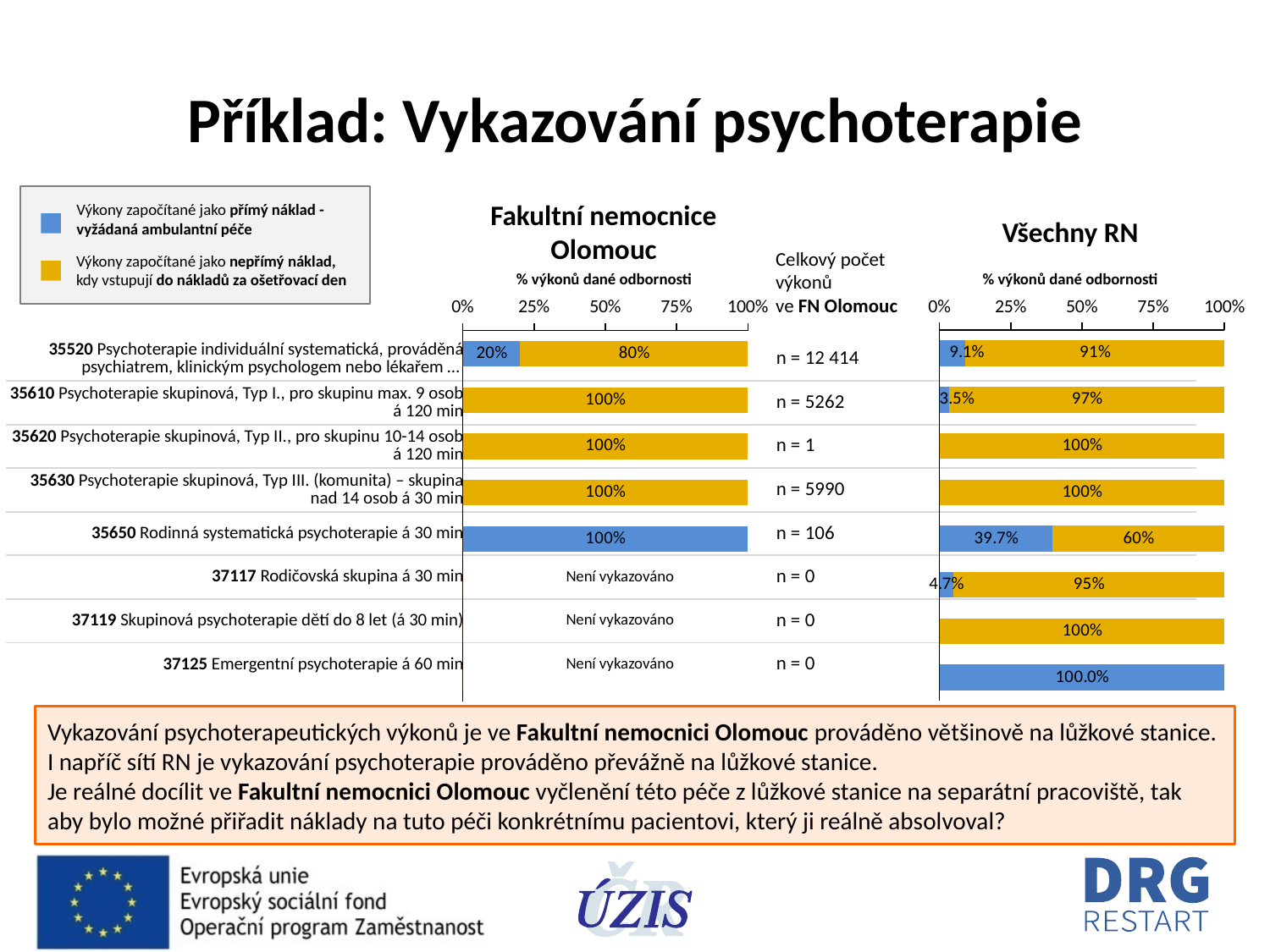
In the Všechny RN chart, what percentage is shown for procedure 37125 Emergentní psychoterapie? 100.0% What is the total number of procedures in FN Olomouc for procedure 35630? n = 5990 In the Všechny RN chart, which has a larger blue segment: procedure 35650 or procedure 37117? 35650 How many series does the legend list? 2 What is the total number of procedures (Celkový počet výkonů) in FN Olomouc for procedure 35520? n = 12 414 In the Fakultní nemocnice Olomouc chart, what percentage of procedure 35520 is shown in the blue (přímý náklad) segment? 20% In the Všechny RN chart, what percentage of procedure 35650 Rodinná systematická psychoterapie is shown in the blue segment? 39.7% In the Všechny RN chart, what percentage of procedure 35610 is shown in the yellow segment? 97% How many procedure categories are listed in the Fakultní nemocnice Olomouc chart? 8 In the Fakultní nemocnice Olomouc chart, what percentage of procedure 35520 is shown in the yellow (nepřímý náklad) segment? 80% What kind of chart is the Všechny RN chart? Bar chart In the Fakultní nemocnice Olomouc chart, how many procedures are marked 'Není vykazováno'? 3